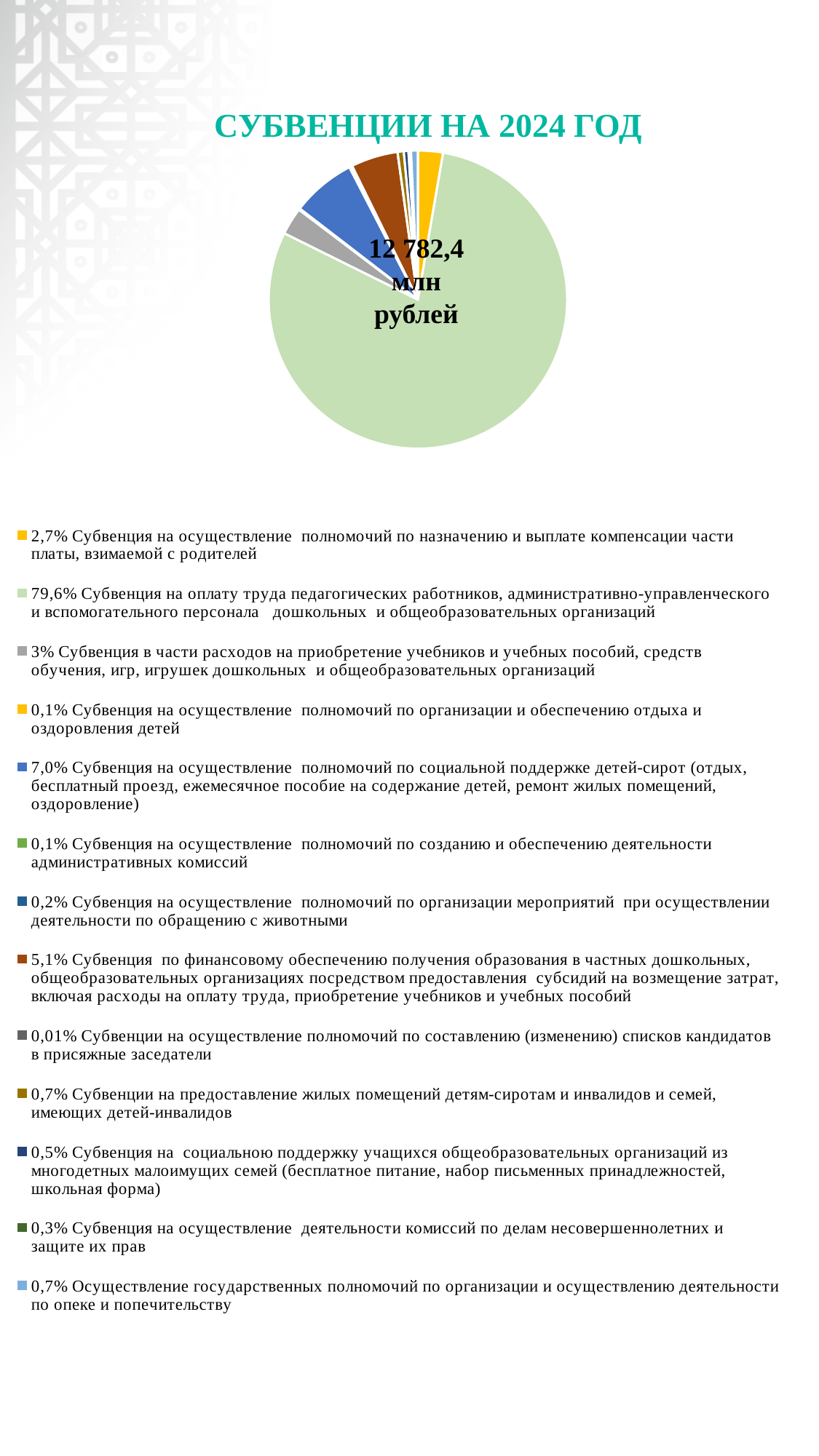
What share of the pie is the subvention for compensation of part of the fee charged to parents (компенсации части платы, взимаемой с родителей)? 2,7% By how many percentage points does the share for teachers' pay (оплату труда педагогических работников) exceed the share for social support of orphaned children (социальной поддержке детей-сирот)? 72,6 percentage points What total amount is printed in the centre of the pie chart? 12 782,4 млн рублей What kind of chart is shown on the slide? pie chart Which category has the smallest share of the pie? Субвенции на осуществление полномочий по составлению (изменению) списков кандидатов в присяжные заседатели (0,01%) Which category has the largest share of the pie? Субвенция на оплату труда педагогических работников, административно-управленческого и вспомогательного персонала дошкольных и общеобразовательных организаций (79,6%) What share of the pie is the subvention for social support of orphaned children (социальной поддержке детей-сирот)? 7,0% Which is larger: the share for financing education in private organisations (частных дошкольных, общеобразовательных организациях) or the share for purchasing textbooks (приобретение учебников)? частных дошкольных, общеобразовательных организациях (5,1%) What is the title of the chart? СУБВЕНЦИИ НА 2024 ГОД What colour is the largest slice of the pie chart? light green What share of the pie is the subvention for purchasing textbooks and teaching aids (приобретение учебников и учебных пособий)? 3% How many categories does the legend of the pie chart list? 13